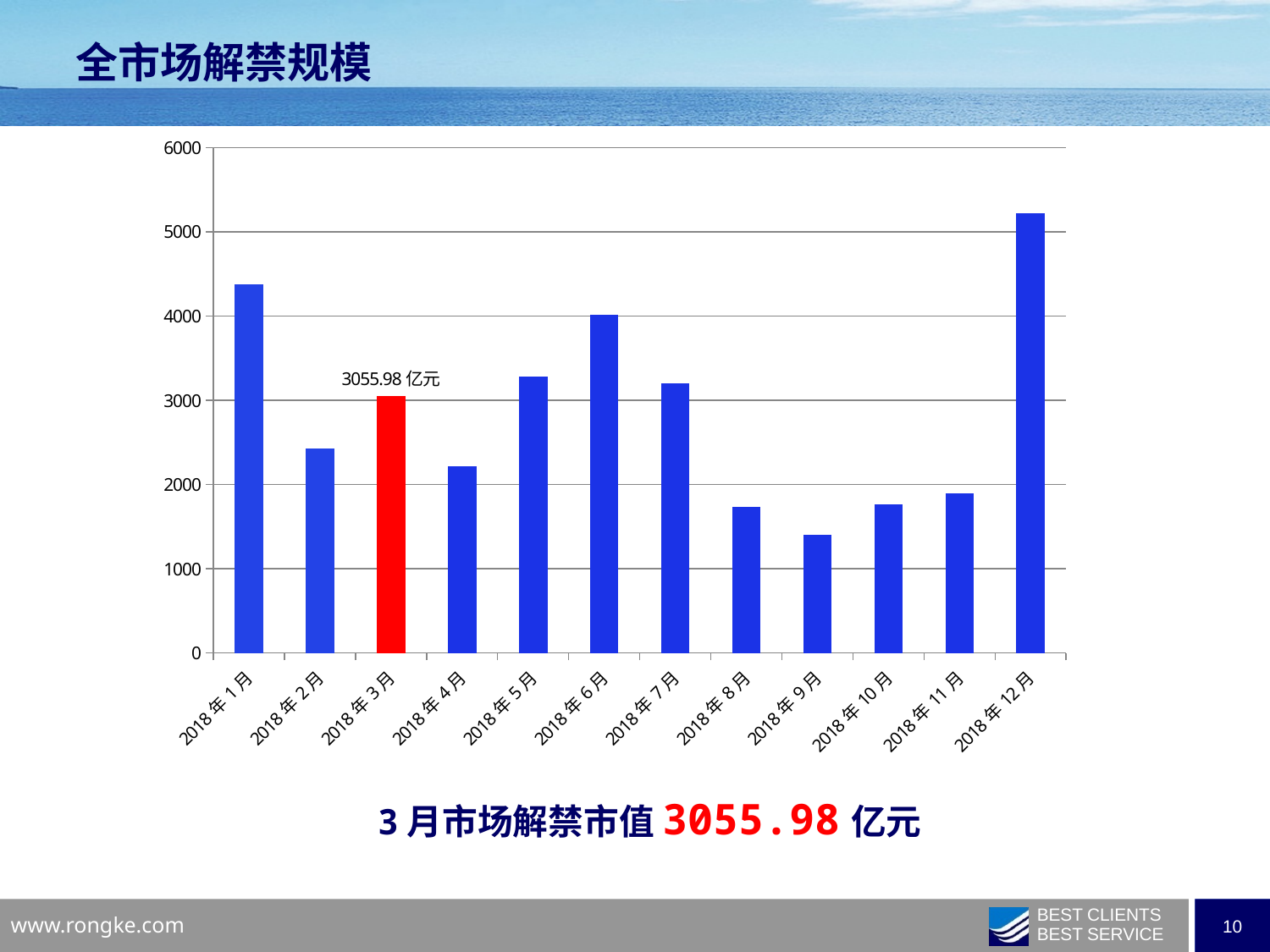
Which month has the highest bar? 2018年12月 Is the value for 2018年12月 greater or less than 5000? greater Is the value for 2018年1月 greater or less than 4000? greater What kind of chart is shown on the slide? bar chart How many months are shown on the x axis? 12 Which is larger, the value for 2018年9月 or 2018年11月? 2018年11月 Which month has the lowest bar? 2018年9月 Which is larger, the value for 2018年1月 or 2018年6月? 2018年1月 Which bar is coloured red instead of blue? 2018年3月 What is the value for 2018年3月? 3055.98 亿元 Is the value for 2018年5月 greater or less than 3000? greater